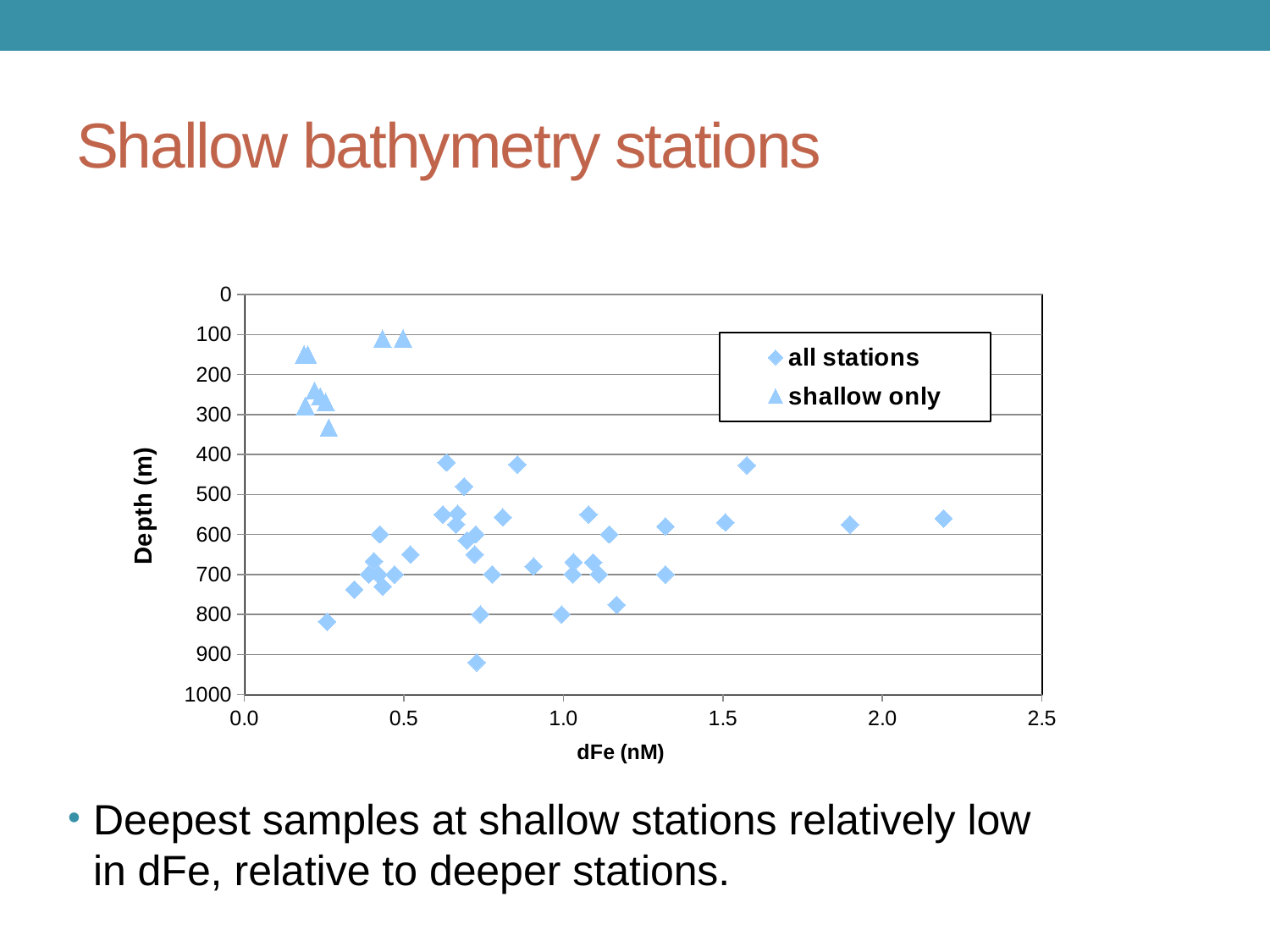
Which series has its points at shallower depths, 'all stations' or 'shallow only'? shallow only What is the title of the x axis of the chart? dFe (nM) What kind of chart is shown on the slide? scatter chart What are the two series named in the chart legend? all stations and shallow only Is the largest dFe value among the 'all stations' points greater or less than 2.0? greater Is the depth of the deepest 'all stations' point greater or less than 800? greater How many series does the chart legend list? 2 Is the highest dFe value among the 'shallow only' points greater or less than 1.0? less What is the maximum depth value shown on the y axis of the chart? 1000 What is the maximum value shown on the x axis of the chart? 2.5